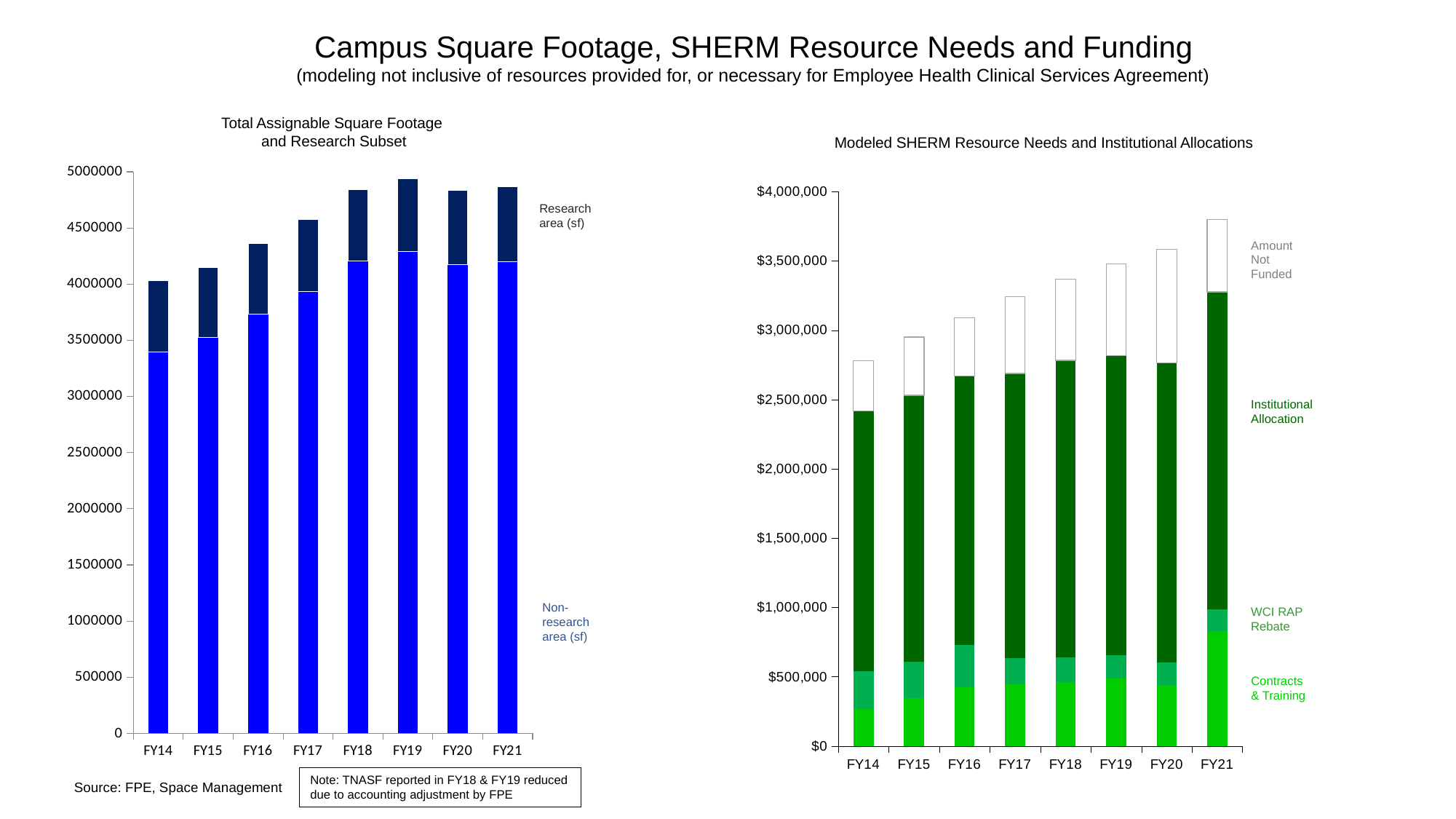
In the left chart, 'Total Assignable Square Footage and Research Subset', is the non-research area for FY14 greater or less than 3500000? less In the left chart, 'Total Assignable Square Footage and Research Subset', which fiscal year has the highest total bar? FY19 How many fiscal years are shown on the x axis of the left chart, 'Total Assignable Square Footage and Research Subset'? 8 In the right chart, 'Modeled SHERM Resource Needs and Institutional Allocations', is the total bar for FY14 greater or less than $2,500,000? greater In the right chart, 'Modeled SHERM Resource Needs and Institutional Allocations', which fiscal year has the highest total bar? FY21 In the left chart, 'Total Assignable Square Footage and Research Subset', which series is shown in dark navy at the top of each bar? Research area (sf) In the left chart, 'Total Assignable Square Footage and Research Subset', which fiscal year has the lowest total bar? FY14 In the right chart, 'Modeled SHERM Resource Needs and Institutional Allocations', do the total bar heights generally rise or fall from FY14 to FY21? rise In the right chart, 'Modeled SHERM Resource Needs and Institutional Allocations', is the total bar for FY21 greater or less than $4,000,000? less How many series are labeled in the right chart, 'Modeled SHERM Resource Needs and Institutional Allocations'? 4 What type of chart is the left chart, 'Total Assignable Square Footage and Research Subset'? Stacked bar chart